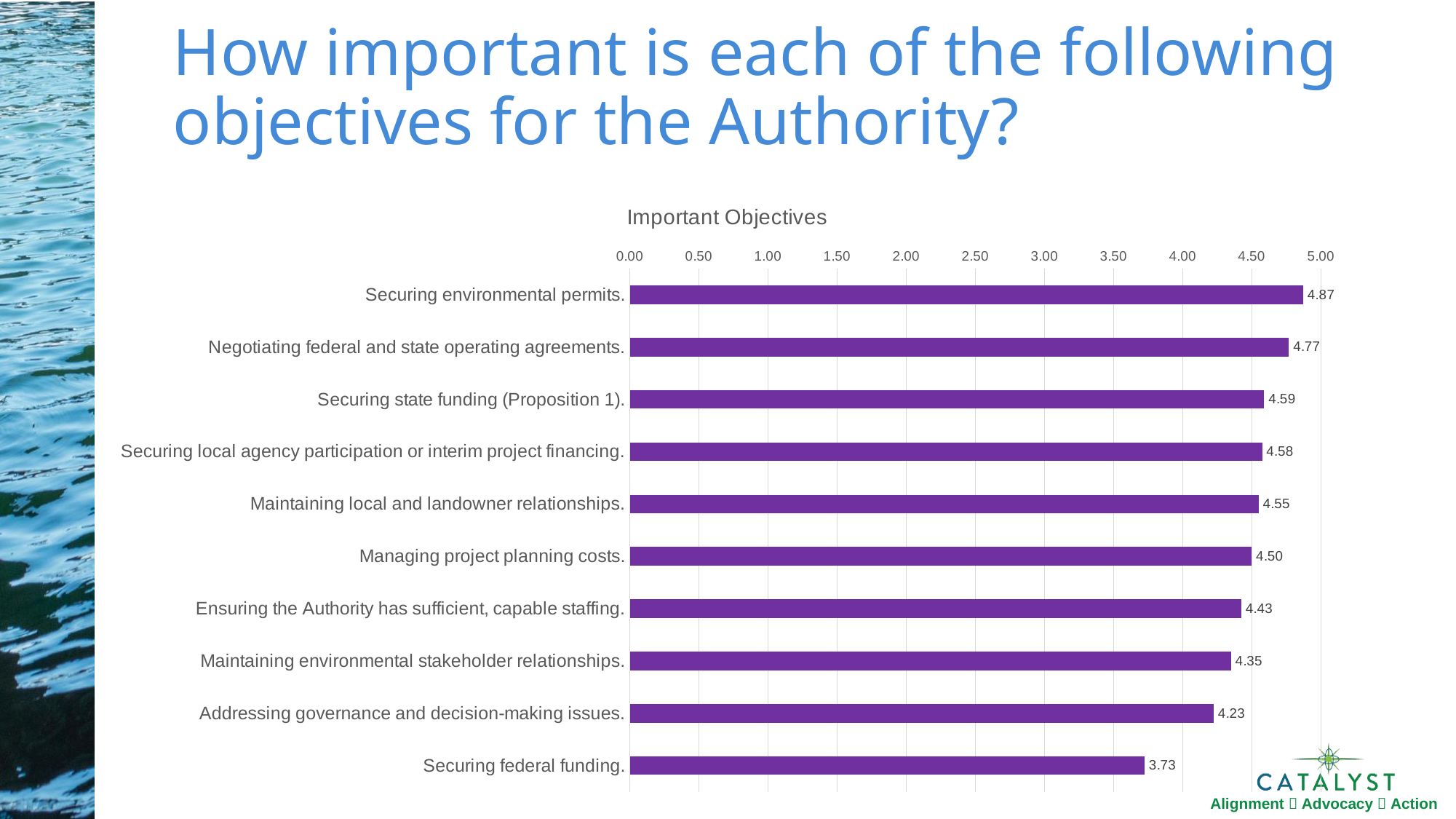
What is the difference between the values for "Securing environmental permits." and "Securing federal funding."? 1.14 What is the title of the chart? Important Objectives Is the value for "Securing federal funding." greater or less than 4.00? less Which objective has the highest value? Securing environmental permits. What is the value for "Securing environmental permits."? 4.87 Which objective has the lowest value? Securing federal funding. What is the value for "Addressing governance and decision-making issues."? 4.23 What is the value for "Securing federal funding."? 3.73 Which is larger: the value for "Negotiating federal and state operating agreements." or "Maintaining environmental stakeholder relationships."? Negotiating federal and state operating agreements. How many objectives are shown in the chart? 10 What is the value for "Managing project planning costs."? 4.50 What kind of chart is shown on the slide? Bar chart